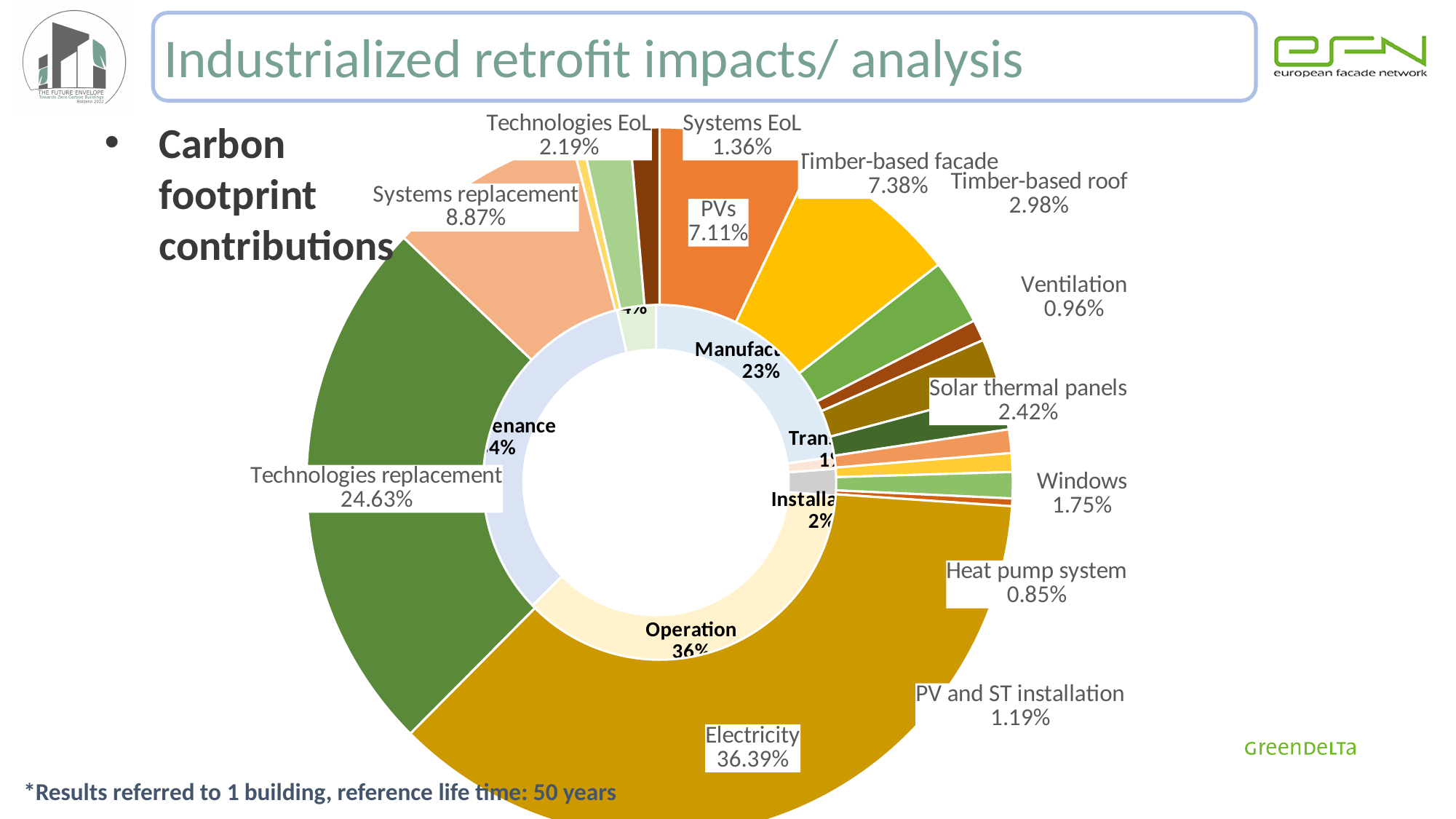
What percentage is shown for Systems replacement? 8.87% What share is shown for the Heat pump system? 0.85% What percentage is shown for Operation in the inner ring? 36% What is the difference between the Electricity share and the Technologies replacement share? 11.76% Which has a larger share, PVs or Timber-based facade? Timber-based facade What percentage is shown for Technologies replacement? 24.63% What type of chart is used on this slide? Doughnut (pie) chart What share of the carbon footprint is attributed to Electricity? 36.39% Which outer-ring category has the largest share of the carbon footprint? Electricity Which labelled outer-ring category has the smallest share? Heat pump system According to the footnote, what reference life time do the results refer to? 50 years What is the value labelled for Timber-based facade? 7.38%